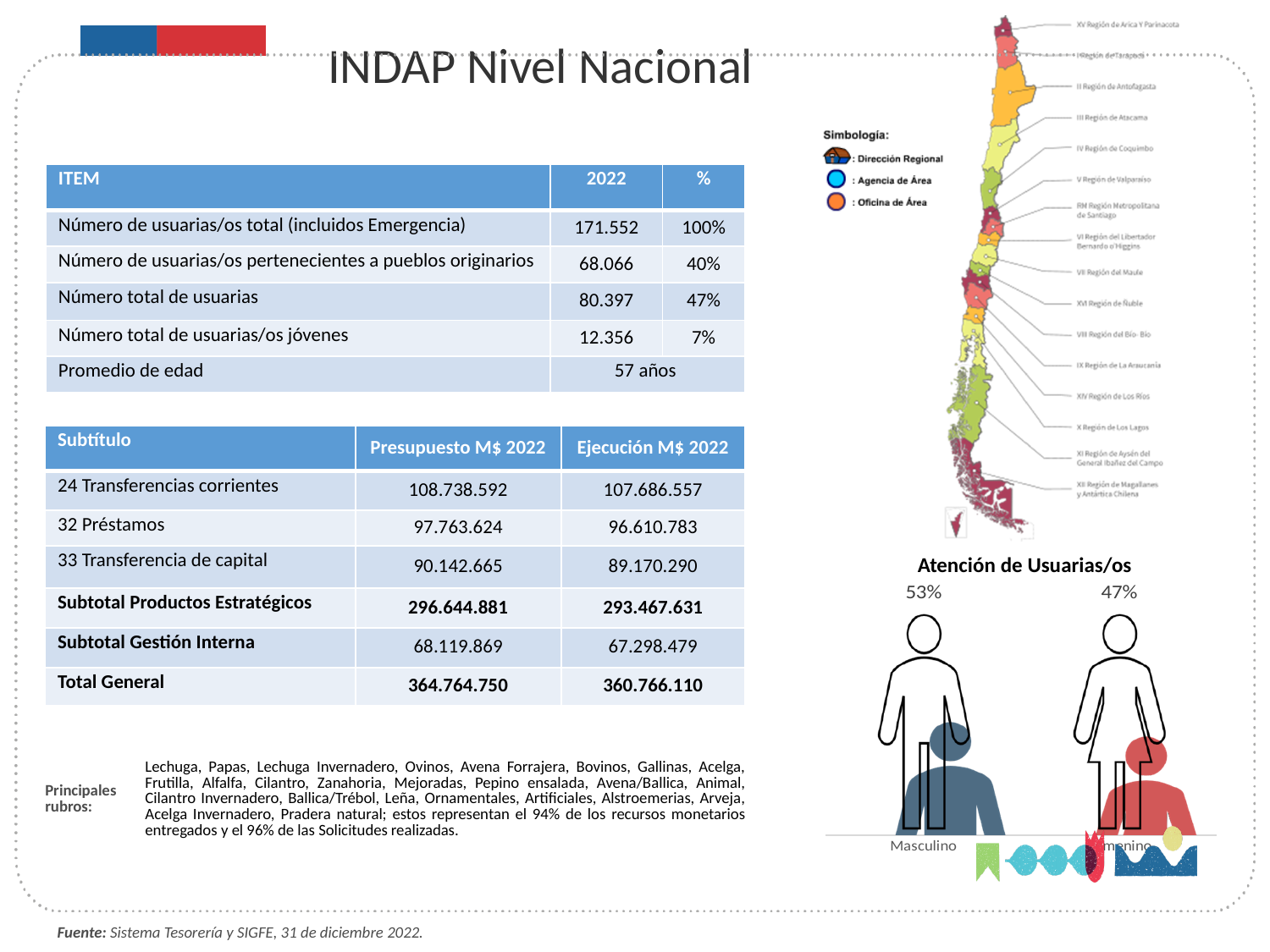
In the 'Atención de Usuarias/os' chart, what is the difference in percentage points between Masculino and Femenino? 6 percentage points In the 'Atención de Usuarias/os' chart, which category has the lower percentage? Femenino What is the title of the chart on the right side of the slide, below the map? Atención de Usuarias/os How many categories are shown in the 'Atención de Usuarias/os' chart? 2 In the 'Atención de Usuarias/os' chart, what percentage is shown for Femenino? 47% In the 'Atención de Usuarias/os' chart, which category has the higher percentage? Masculino In the 'Atención de Usuarias/os' chart, what percentage is shown for Masculino? 53% In the 'Atención de Usuarias/os' chart, is the value for Masculino larger or smaller than the value for Femenino? larger What kind of chart is 'Atención de Usuarias/os'? pictogram In the 'Atención de Usuarias/os' chart, what colour is the figure for Masculino? blue What do the two percentages in the 'Atención de Usuarias/os' chart add up to? 100%